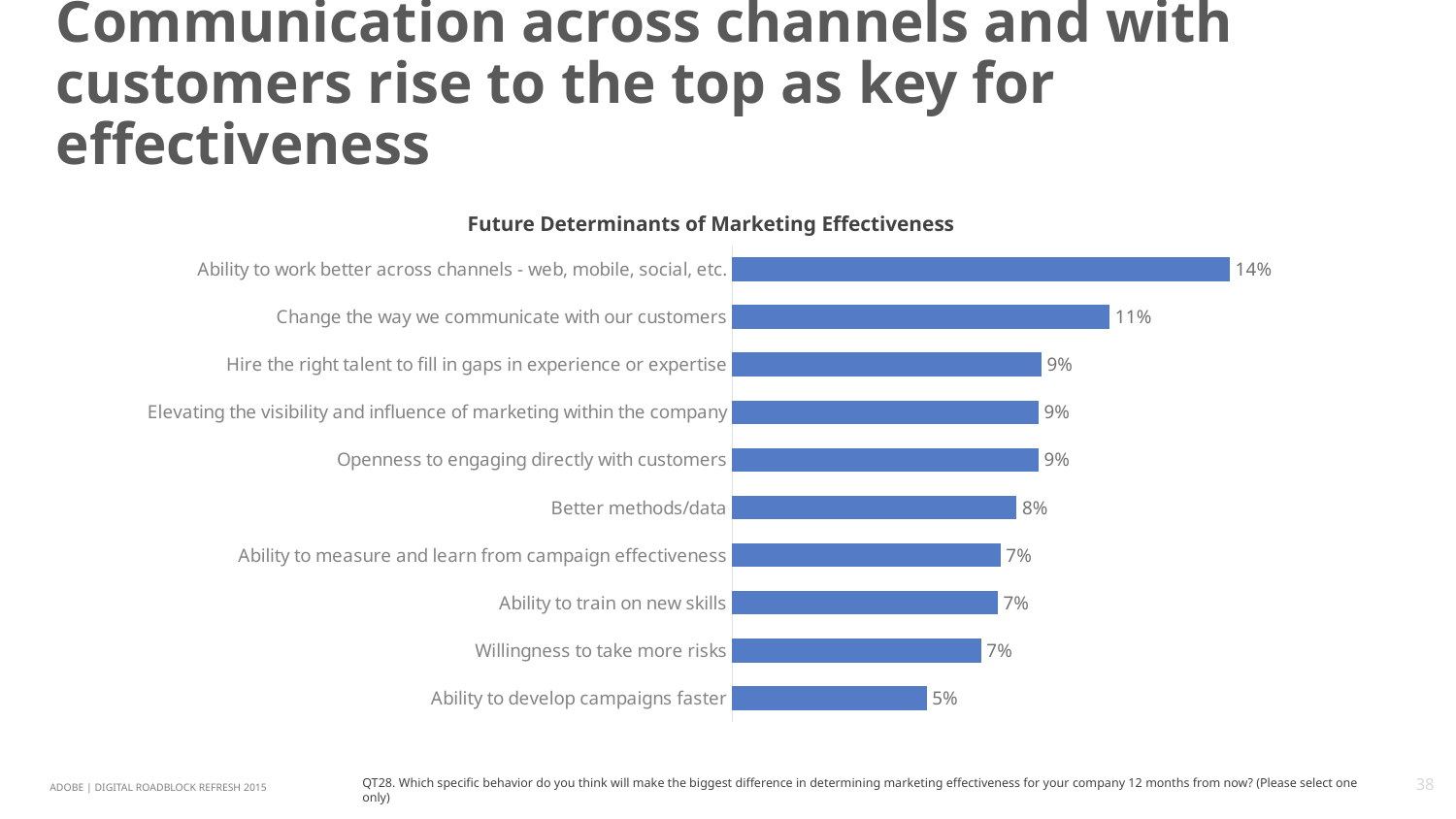
Which is larger: the value for "Better methods/data" or the value for "Willingness to take more risks"? Better methods/data What is the difference between the values for "Ability to work better across channels - web, mobile, social, etc." and "Change the way we communicate with our customers"? 3% What kind of chart is shown on the slide? Bar chart What is the value for "Change the way we communicate with our customers"? 11% Which category has the highest value? Ability to work better across channels - web, mobile, social, etc. How many categories have a value of 9%? 3 What is the value for "Better methods/data"? 8% Which category has the lowest value? Ability to develop campaigns faster What is the value for "Ability to develop campaigns faster"? 5% How many categories are shown in the chart? 10 What is the title of the chart? Future Determinants of Marketing Effectiveness What is the value for "Ability to work better across channels - web, mobile, social, etc."? 14%